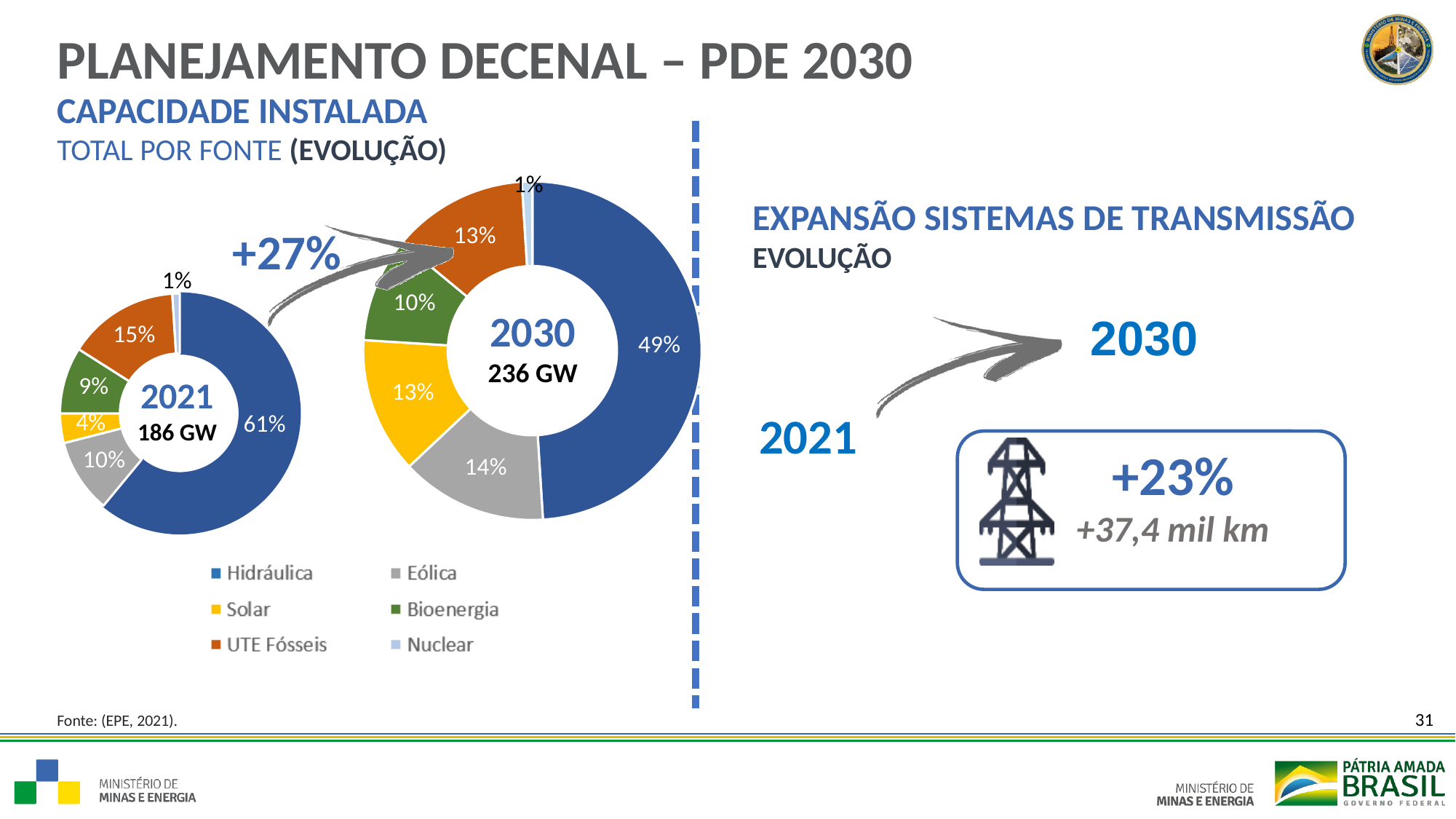
In the 2030 donut chart, what share does Eólica have? 14% In the 2021 donut chart, what share does Hidráulica have? 61% How many sources are shown in the legend of the donut charts? 6 In the 2030 donut chart, which source has the smallest share? Nuclear What type of chart is used to show the installed capacity by source? Donut (pie) chart In the 2030 donut chart, what share does Hidráulica have? 49% Which colour represents UTE Fósseis in the donut charts? Orange What is the difference between the Hidráulica share in the 2021 chart and in the 2030 chart? 12 percentage points What total installed capacity is shown in the centre of the 2030 donut chart? 236 GW In the 2030 donut chart, which is larger: the share of Eólica or the share of Bioenergia? Eólica In the 2021 donut chart, what share does Solar have? 4% In the 2021 donut chart, which source has the largest share? Hidráulica